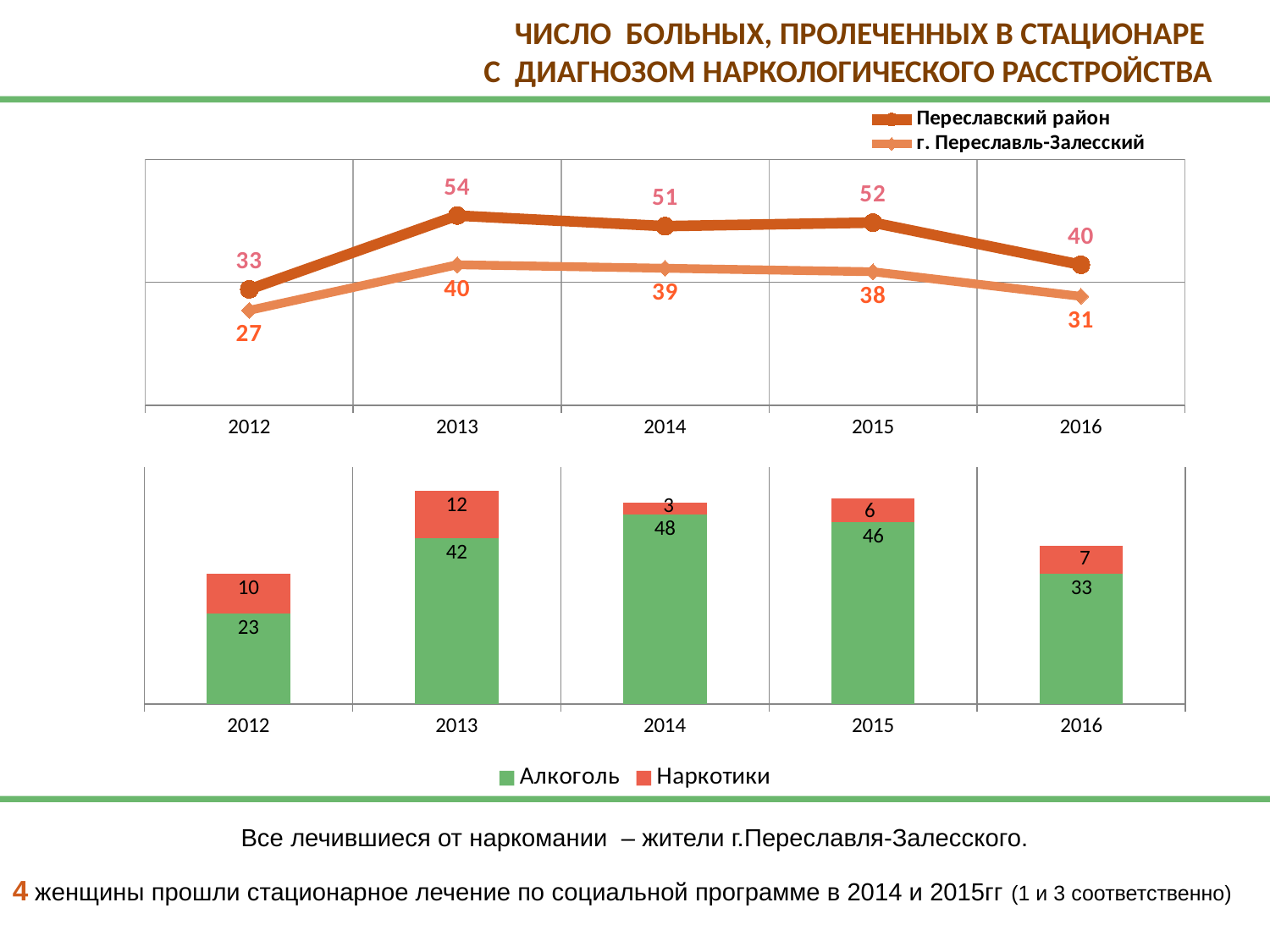
What type of chart is the bottom chart? Stacked bar chart In the top line chart, what is the value for Переславский район in 2013? 54 In the bottom chart, is the Алкоголь value larger in 2012 or in 2015? 2015 In the top line chart, what is the value for г. Переславль-Залесский in 2016? 31 In the bottom chart, which year has the highest Алкоголь value? 2014 In the top line chart, which year has the highest value for Переславский район? 2013 In the top line chart, what is the difference between Переславский район and г. Переславль-Залесский in 2015? 14 How many series does the legend of the top line chart list? 2 In the top line chart, which year has the lowest value for г. Переславль-Залесский? 2012 In the bottom chart, what is the Алкоголь value for 2016? 33 In the bottom chart, what is the total of the stacked bar for 2013? 54 In the bottom chart, what is the Наркотики value for 2014? 3